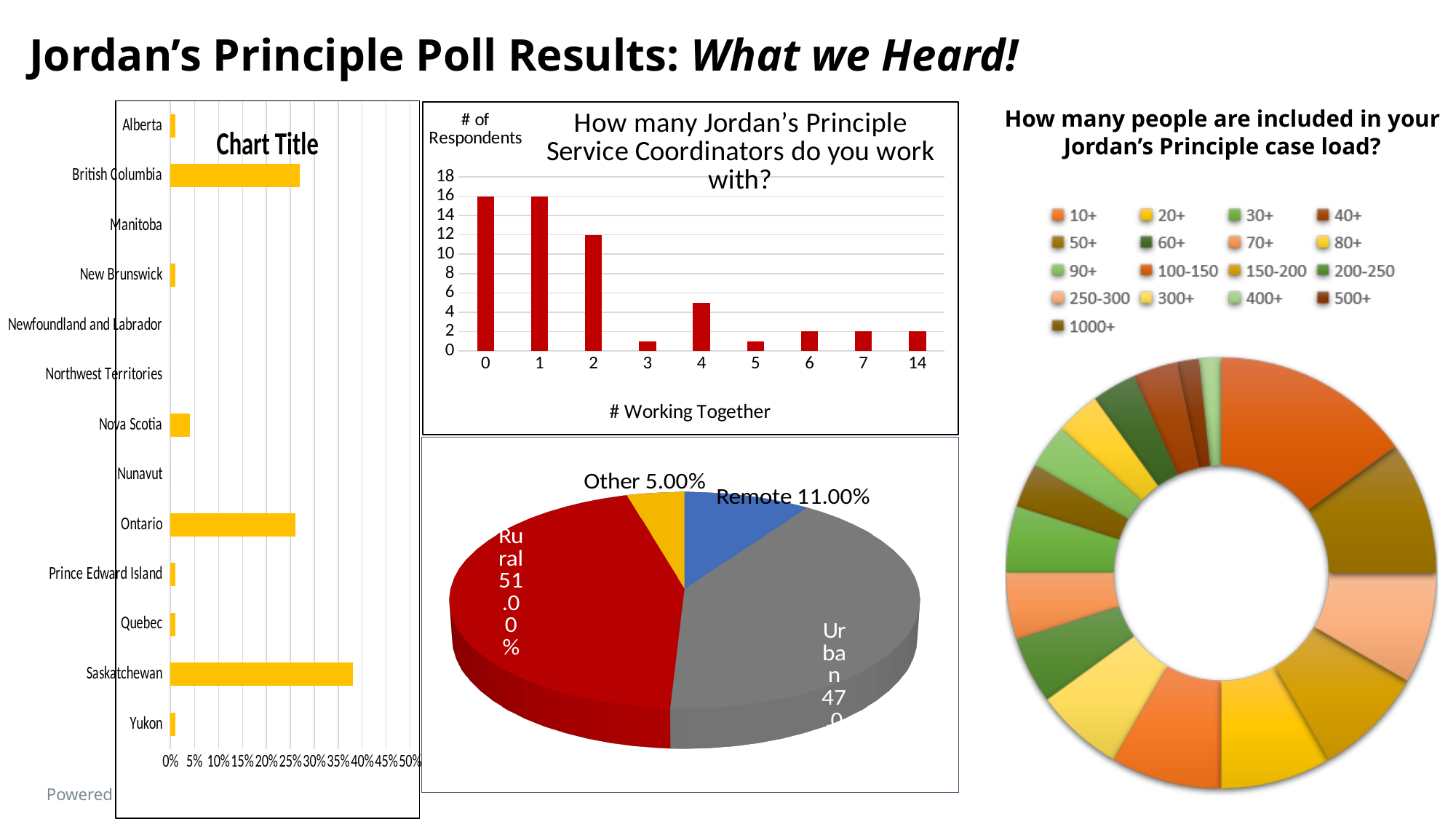
In the chart titled 'How many people are included in your Jordan's Principle case load?', how many entries does the legend list? 17 In the pie chart in the middle bottom of the slide, what share is Rural? 51.00% In the chart titled 'How many Jordan's Principle Service Coordinators do you work with?', is the value for 4 coordinators greater or less than 4? greater In the pie chart in the middle bottom of the slide, what is the difference between the Rural and Remote shares? 40.00% In the pie chart in the middle bottom of the slide, what is the value for Remote? 11.00% In the chart titled 'How many Jordan's Principle Service Coordinators do you work with?', how many respondents work with 2 coordinators? 12 In the chart titled 'Chart Title' on the left of the slide, is the value for Ontario greater or less than 20%? greater In the chart titled 'Chart Title' on the left of the slide, which province or territory has the highest value? Saskatchewan In the pie chart in the middle bottom of the slide, which slice is the smallest? Other In the chart titled 'How many Jordan's Principle Service Coordinators do you work with?', what is the x-axis title? # Working Together In the chart titled 'How many Jordan's Principle Service Coordinators do you work with?', how many respondents work with 0 coordinators? 16 In the chart titled 'How many Jordan's Principle Service Coordinators do you work with?', how many categories are shown on the x axis? 9